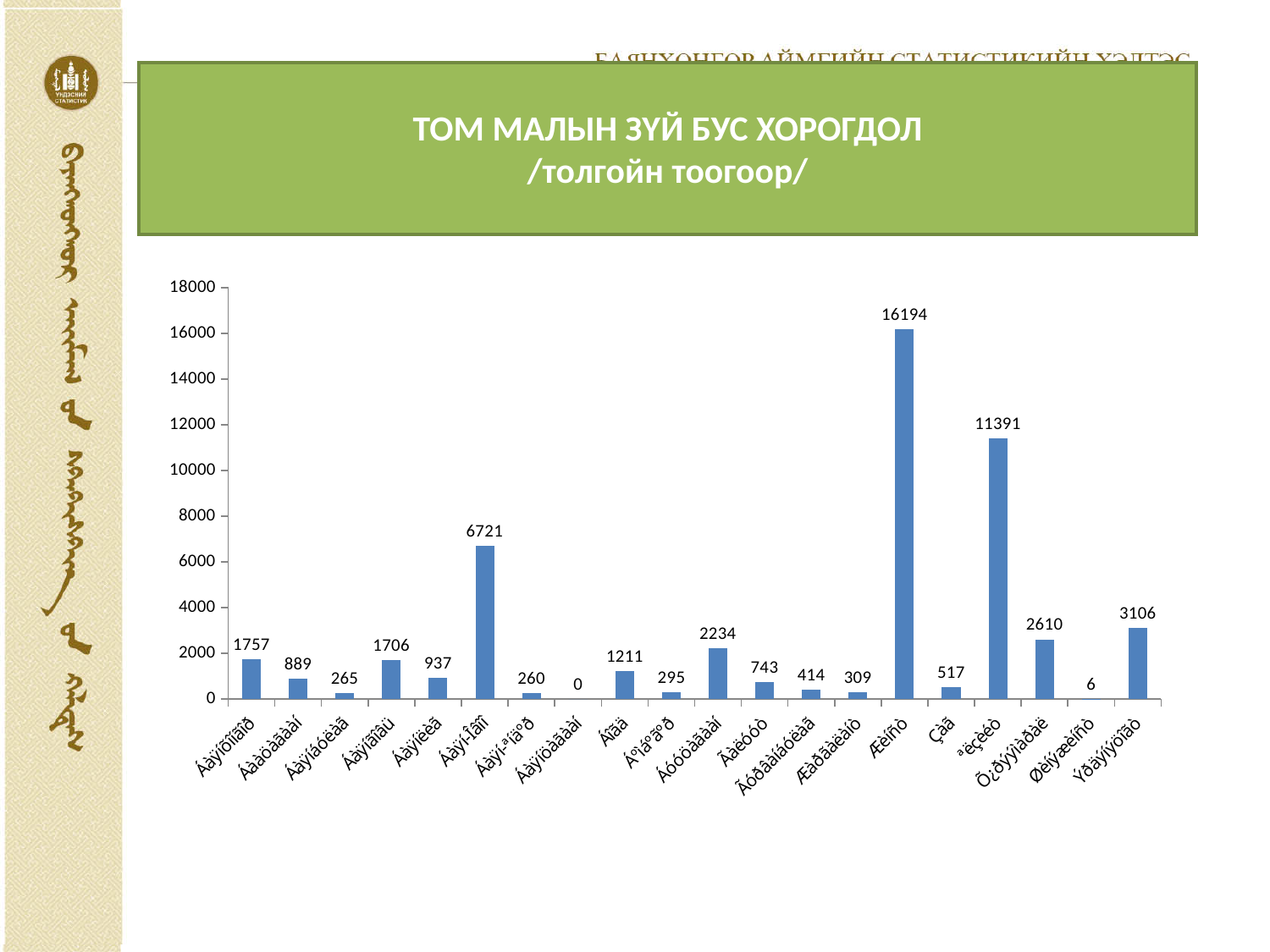
Is the value of the second tallest bar greater or less than 10000? greater Which is larger: the bar labelled 2610 or the bar labelled 2234? 2610 What is the value of the first (leftmost) bar in the chart? 1757 How many bars (categories) are plotted in the chart? 20 What is the title of the chart on the slide? ТОМ МАЛЫН ЗҮЙ БУС ХОРОГДОЛ /толгойн тоогоор/ What is the highest tick value shown on the vertical axis of the chart? 18000 What is the lowest value shown in the chart? 0 What is the highest value shown in the chart? 16194 What is the difference between the tallest bar (16194) and the second tallest bar (11391)? 4803 What is the value of the sixth bar from the left in the chart? 6721 What is the value of the last (rightmost) bar in the chart? 3106 What kind of chart is shown on the slide? bar chart